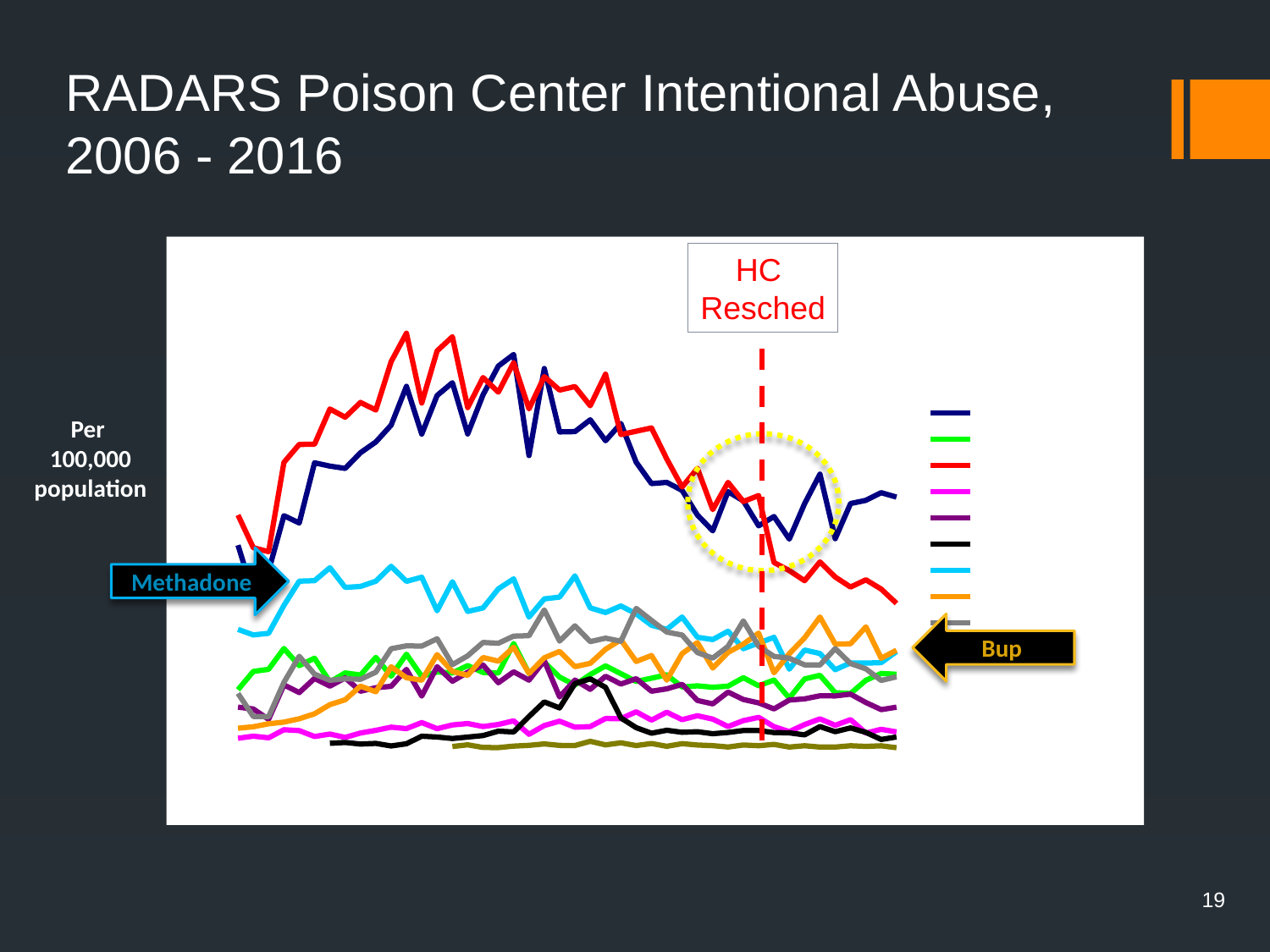
At the start of the period, which is higher, the Methadone line or the Bup line? Methadone Does the Methadone line rise or fall over the second half of the chart? fall Which line reaches the highest point on the chart, the red line or the Methadone line? red line At the start of the period, which is higher, the red line or the Methadone line? red line At the end of the period, which is higher, the navy line or the red line? navy line What is the label on the vertical axis of the chart? Per 100,000 population Does the red line rise or fall from the start of the chart to its peak? rise Does the red line rise or fall after the HC Resched dashed line? fall What event does the dashed vertical red line on the chart mark? HC Resched What kind of chart is shown on the slide? line chart